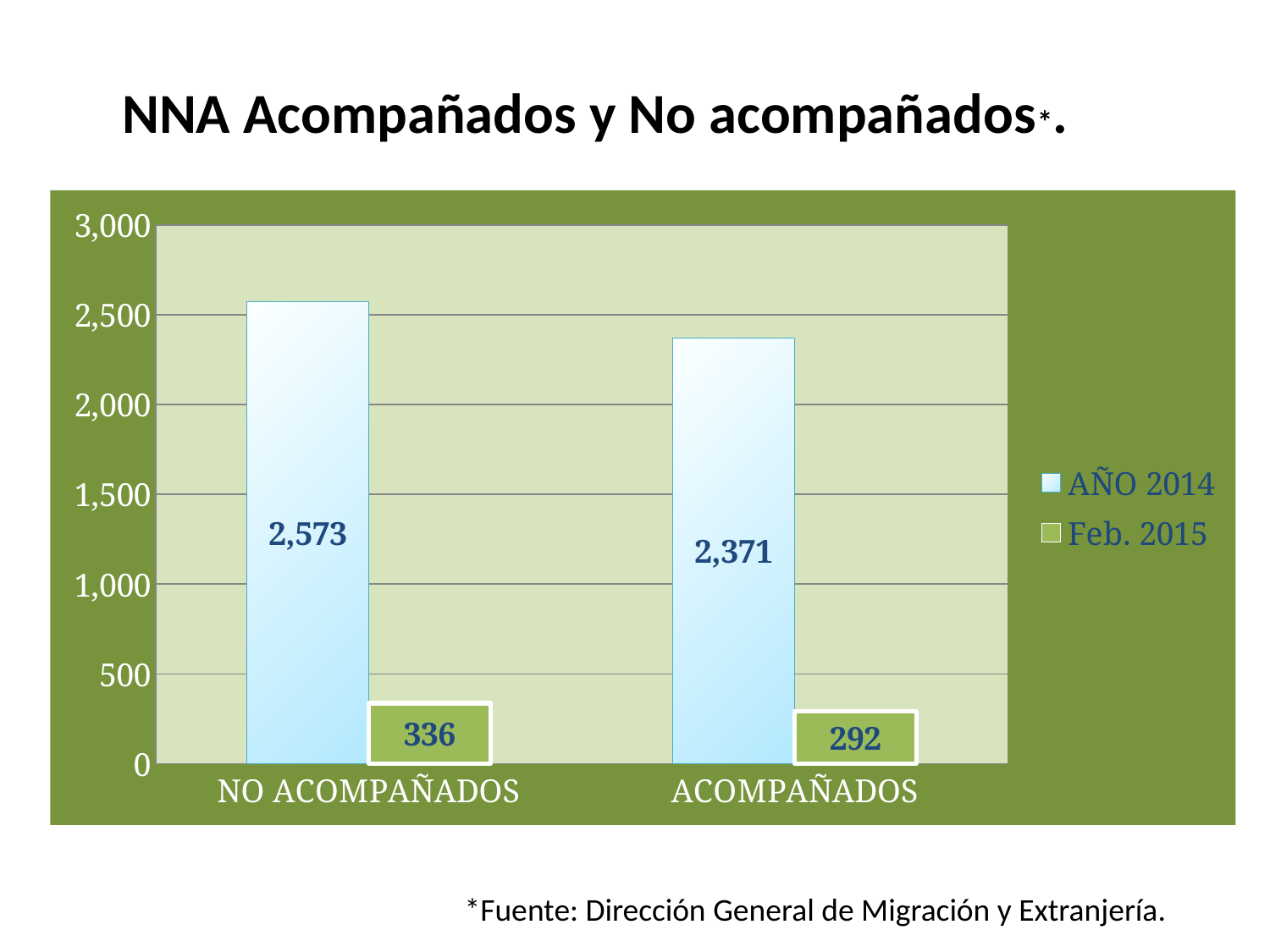
Which is larger: the Feb. 2015 value for NO ACOMPAÑADOS or for ACOMPAÑADOS? NO ACOMPAÑADOS How many categories are shown on the x axis? 2 How many series does the legend list? 2 What is the Feb. 2015 value for ACOMPAÑADOS? 292 What is the Feb. 2015 value for NO ACOMPAÑADOS? 336 What kind of chart is shown on the slide? bar chart Which category has the highest AÑO 2014 value? NO ACOMPAÑADOS What is the AÑO 2014 value for ACOMPAÑADOS? 2,371 What is the difference between the AÑO 2014 values for NO ACOMPAÑADOS and ACOMPAÑADOS? 202 Which category has the lowest Feb. 2015 value? ACOMPAÑADOS What is the AÑO 2014 value for NO ACOMPAÑADOS? 2,573 Is the AÑO 2014 value for ACOMPAÑADOS greater or less than 2,500? less